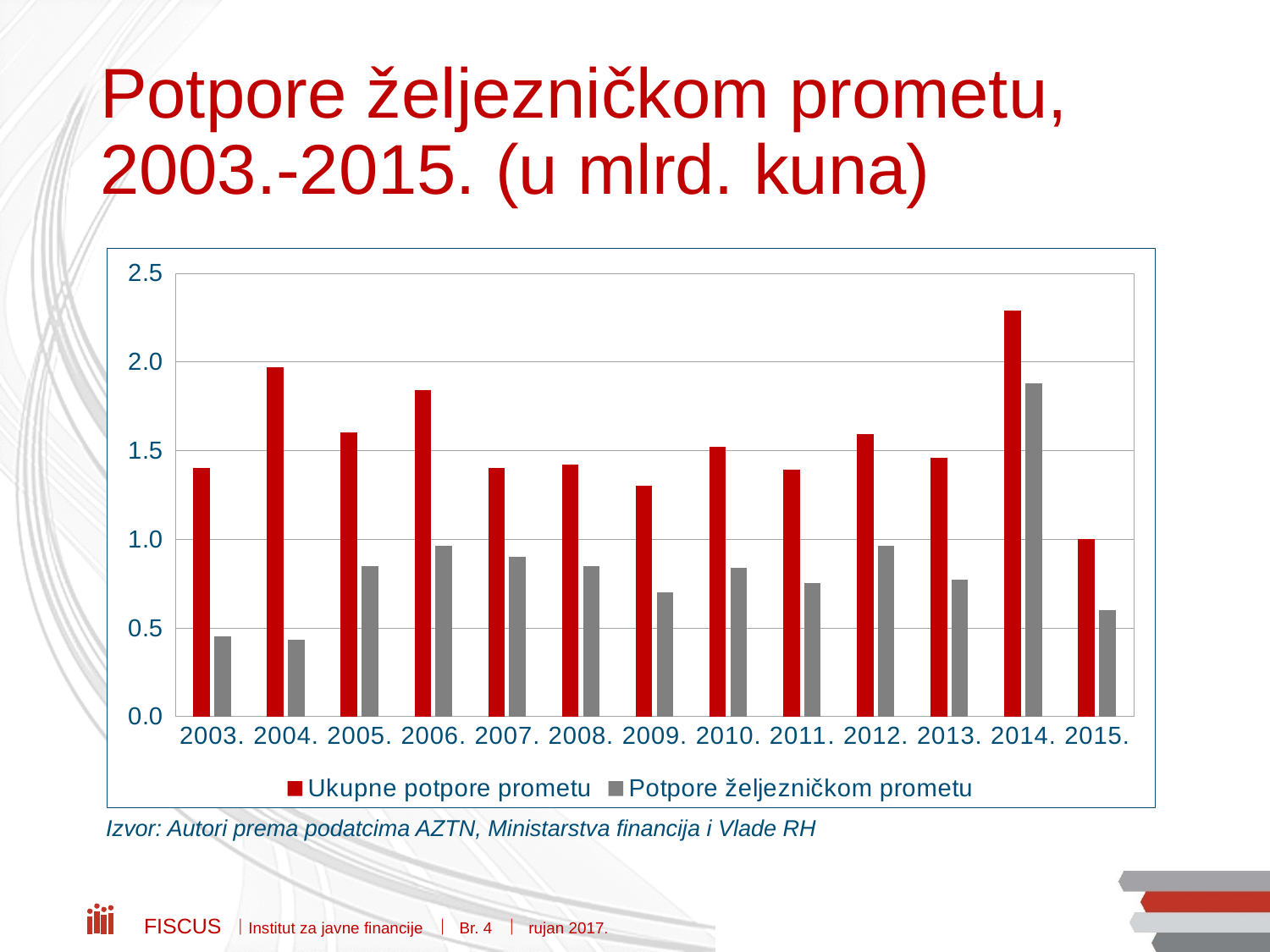
How many years are shown on the x axis? 13 Which is larger: Ukupne potpore prometu in 2004. or Ukupne potpore prometu in 2009.? 2004. What kind of chart is shown on the slide? bar chart In which year are the railway transport subsidies (Potpore željezničkom prometu) highest? 2014. Is the value for Ukupne potpore prometu in 2014. greater or less than 2.0? greater Which colour represents Potpore željezničkom prometu in the legend? grey How many series does the legend list? 2 Is the value for Potpore željezničkom prometu in 2003. greater or less than 0.5? less In which year are the total transport subsidies (Ukupne potpore prometu) lowest? 2015. Is the value for Potpore željezničkom prometu in 2014. greater or less than 1.5? greater From 2014. to 2015., do the total transport subsidies (Ukupne potpore prometu) rise or fall? fall In which year are the total transport subsidies (Ukupne potpore prometu) highest? 2014.